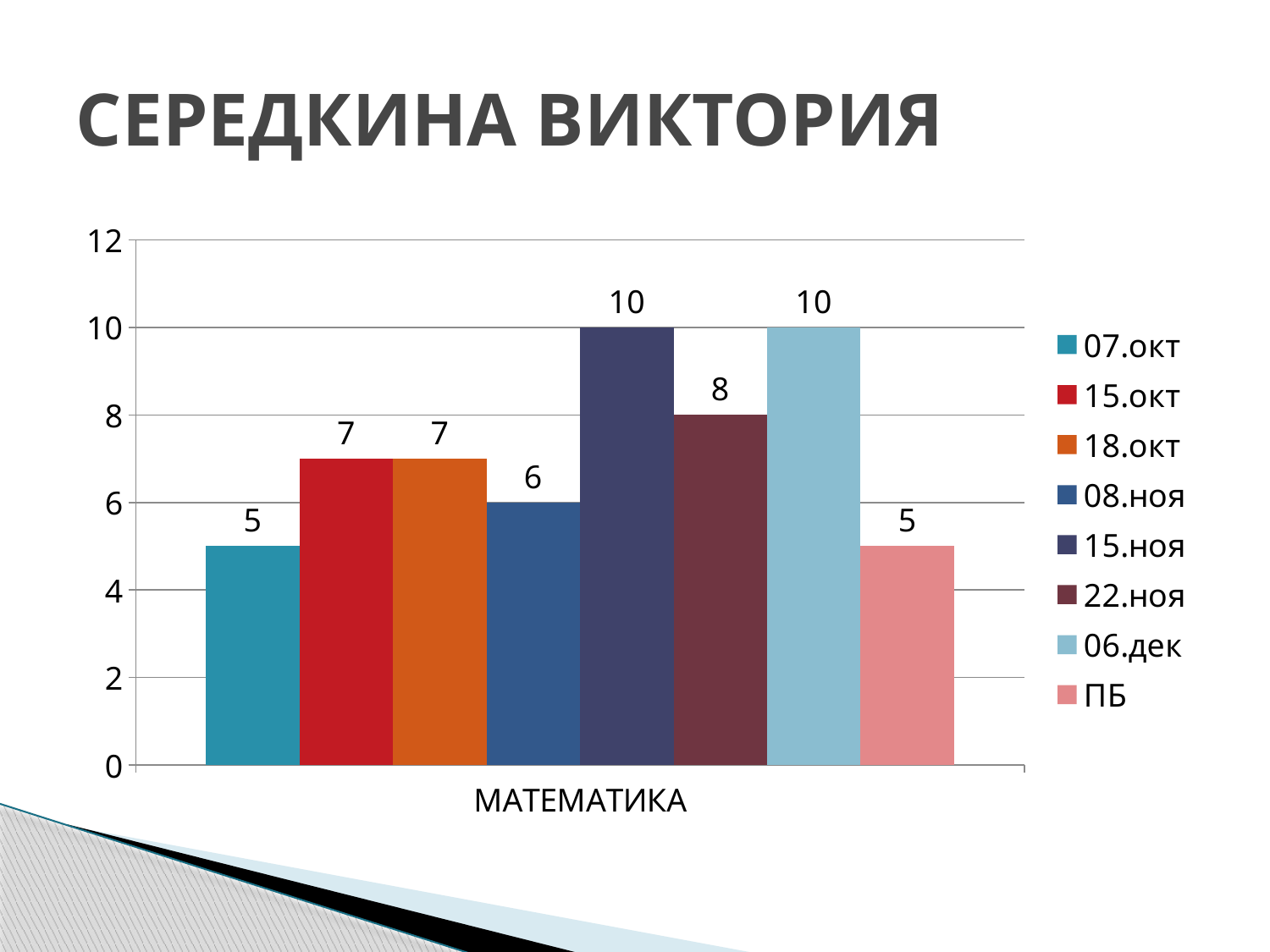
Which is larger, the value for 18.окт or the value for 22.ноя? 22.ноя What is the difference between the values for 15.ноя and 07.окт? 5 What kind of chart is shown on the slide? Bar chart What is the difference between the values for 22.ноя and 08.ноя? 2 How many series does the legend list? 8 Which series has the lowest value, 08.ноя or 15.окт? 08.ноя What is the value for the 08.ноя series? 6 What is the value for the 22.ноя series? 8 What is the category label shown on the x axis? МАТЕМАТИКА What is the value for the ПБ series? 5 Is the value for 15.ноя greater or less than 8? greater What is the value for the 07.окт series in the МАТЕМАТИКА category? 5